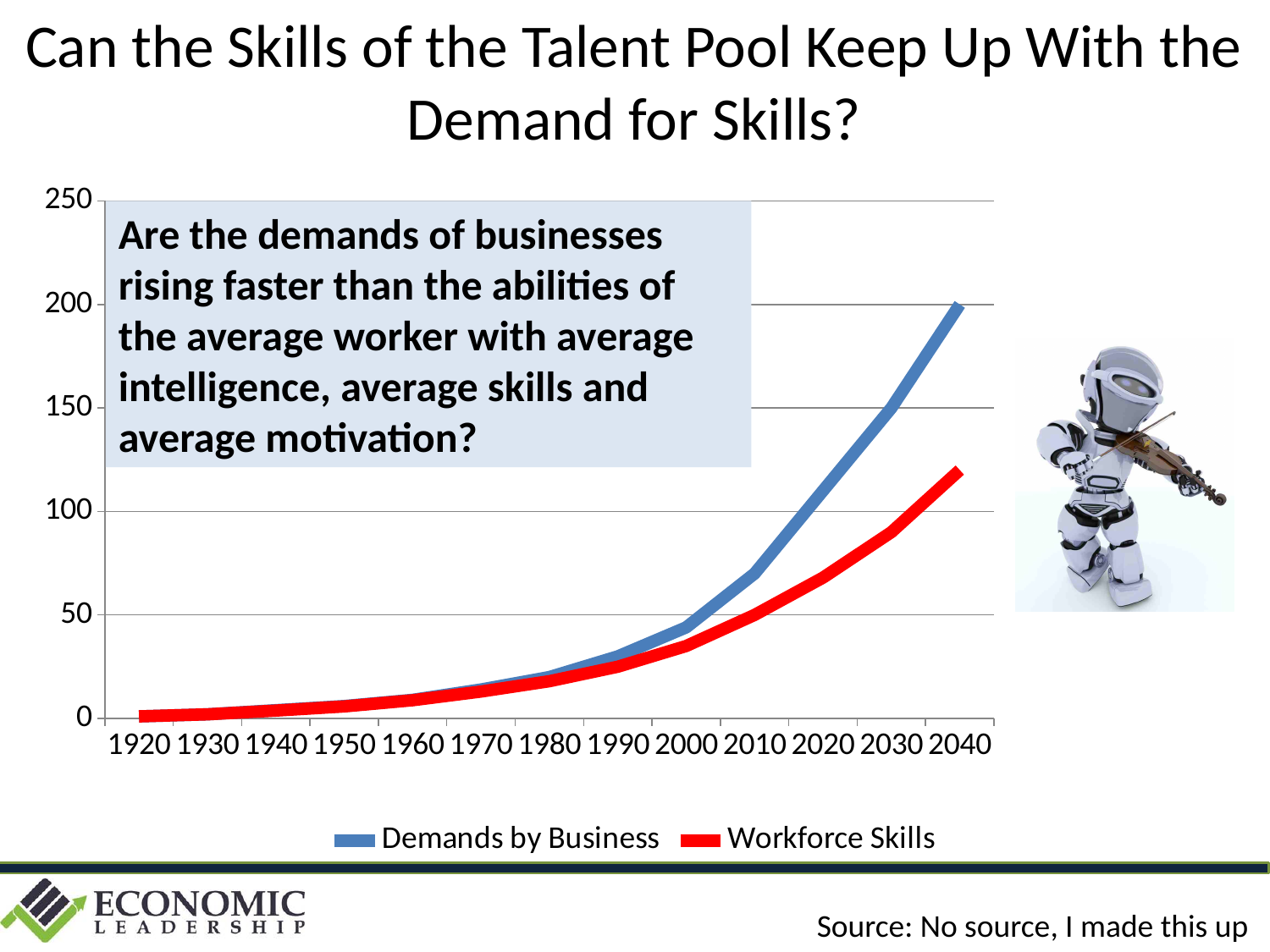
Which series is drawn in blue? Demands by Business Is the value for Demands by Business in 2040 greater or less than 150? greater What kind of chart is shown on the slide? line chart Is the value for Demands by Business in 2010 greater or less than 100? less In 2040, which series has the larger value, Demands by Business or Workforce Skills? Demands by Business Do the values for Demands by Business rise or fall from 1920 to 2040? rise Is the value for Workforce Skills in 2020 greater or less than 100? less How many series does the legend list? 2 What colour is the Workforce Skills line? red In which year does Demands by Business reach its highest value? 2040 How many years are labelled along the x axis? 13